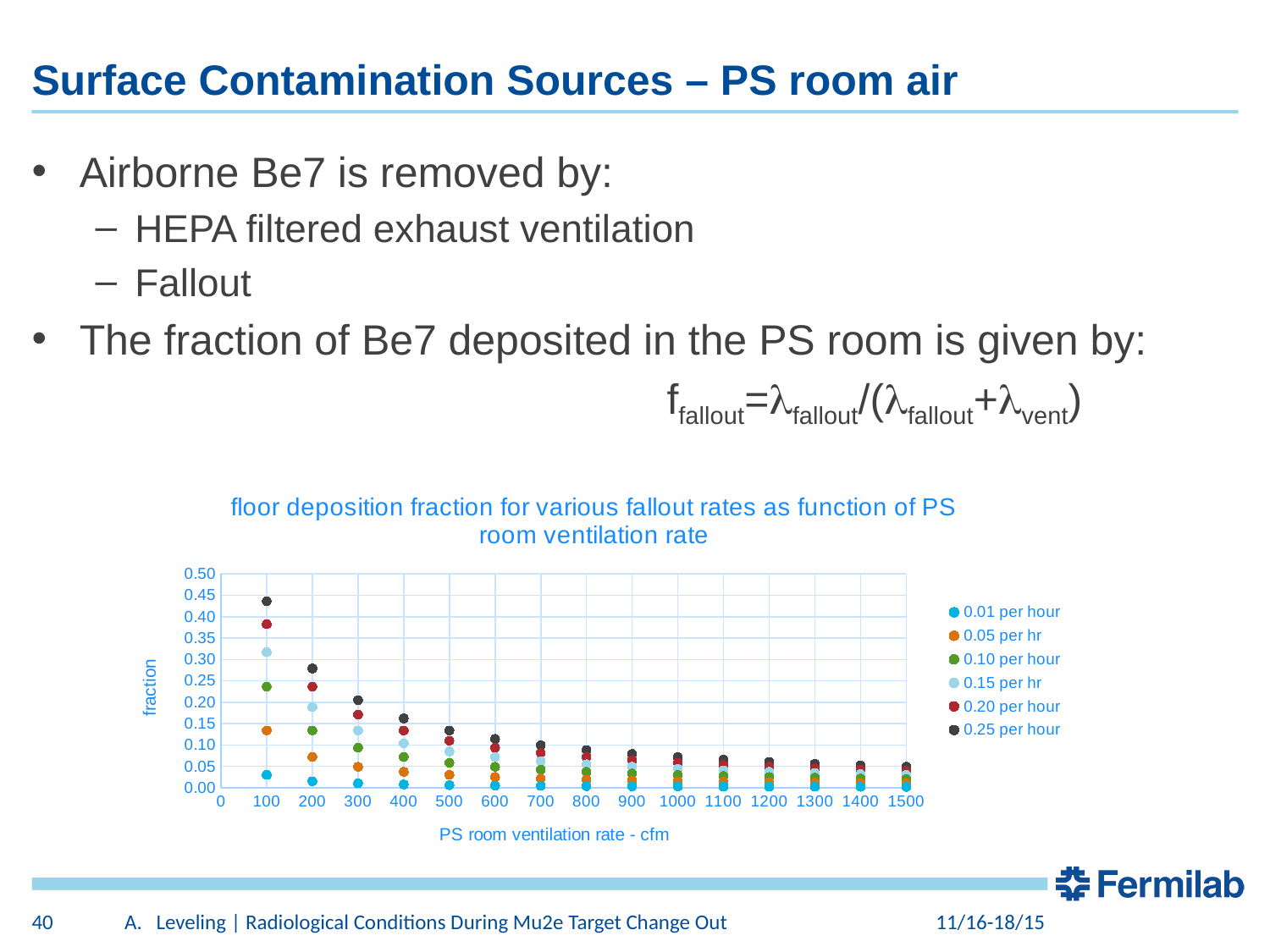
Is the fraction for the 0.25 per hour series at 100 cfm greater or less than 0.40? greater Which series has the highest fraction at a ventilation rate of 100 cfm? 0.25 per hour Do the fraction values rise or fall as the PS room ventilation rate increases? fall At 200 cfm, which series has the larger fraction: 0.25 per hour or 0.10 per hour? 0.25 per hour Is the fraction for the 0.01 per hour series at 100 cfm greater or less than 0.05? less Is the fraction for the 0.20 per hour series at 100 cfm greater or less than 0.35? greater Which series has the lowest fraction at a ventilation rate of 100 cfm? 0.01 per hour What is the label of the x axis of the chart? PS room ventilation rate - cfm What is the label of the y axis of the chart? fraction What kind of chart is shown on the slide? scatter chart How many series does the chart legend list? 6